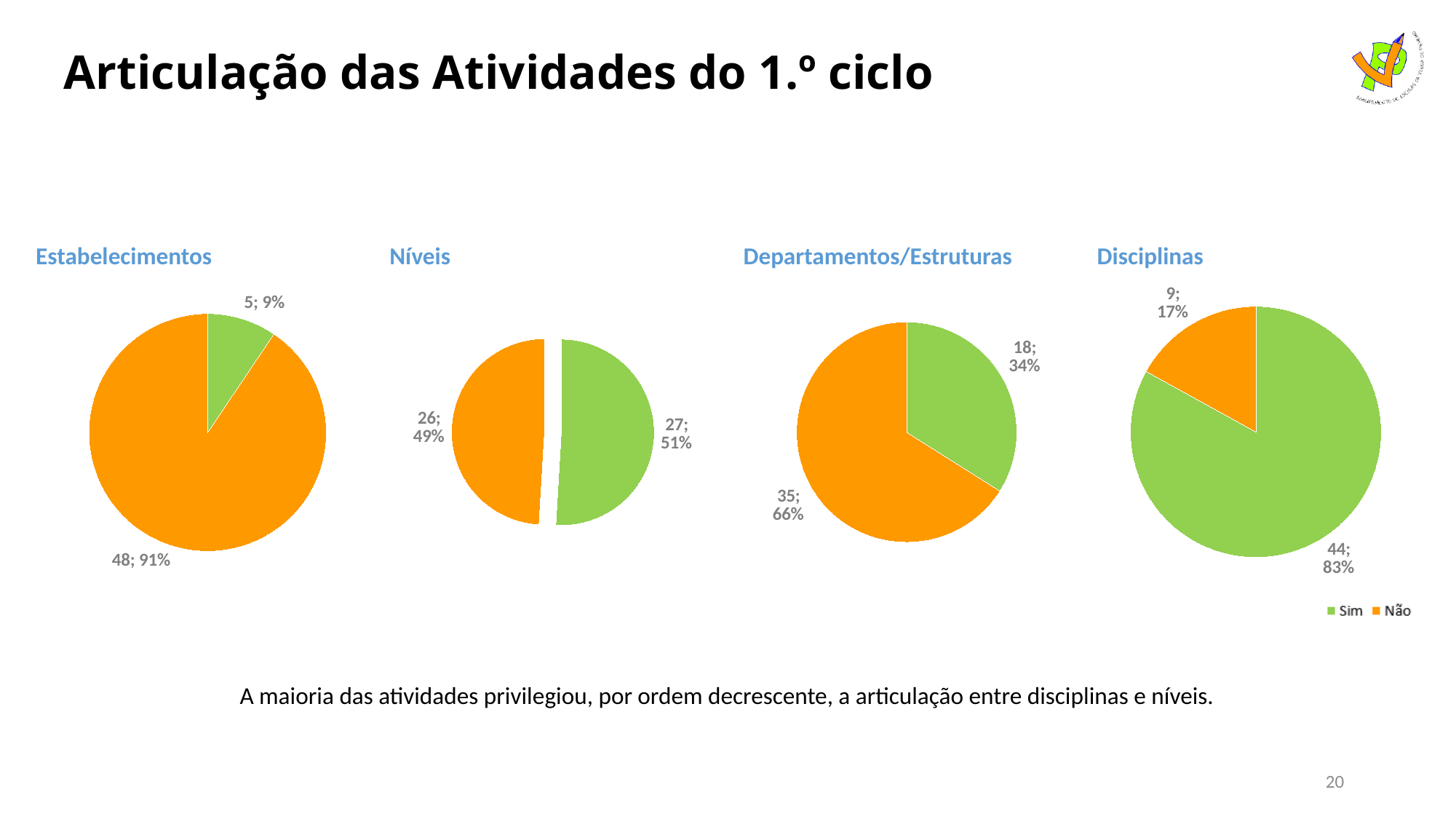
In the Estabelecimentos pie chart, what share of the pie does the Sim slice represent? 9% In the Níveis pie chart, what is the value shown for the Sim slice? 27; 51% In the Disciplinas pie chart, what is the value shown for the Não slice? 9; 17% What kind of chart is used for Estabelecimentos? Pie chart How many entries does the legend list for the charts on this slide? 2 In the Disciplinas pie chart, what share of the pie does the Sim slice represent? 83% In the Departamentos/Estruturas pie chart, which slice is larger, Sim or Não? Não In the Estabelecimentos pie chart, what is the value shown for the Não slice? 48; 91% Which colour represents Sim in the pie charts? Green In the Departamentos/Estruturas pie chart, what is the value shown for the Não slice? 35; 66% In the Disciplinas pie chart, what is the total of the Sim and Não counts? 53 In the Níveis pie chart, what is the difference between the Sim count and the Não count? 1